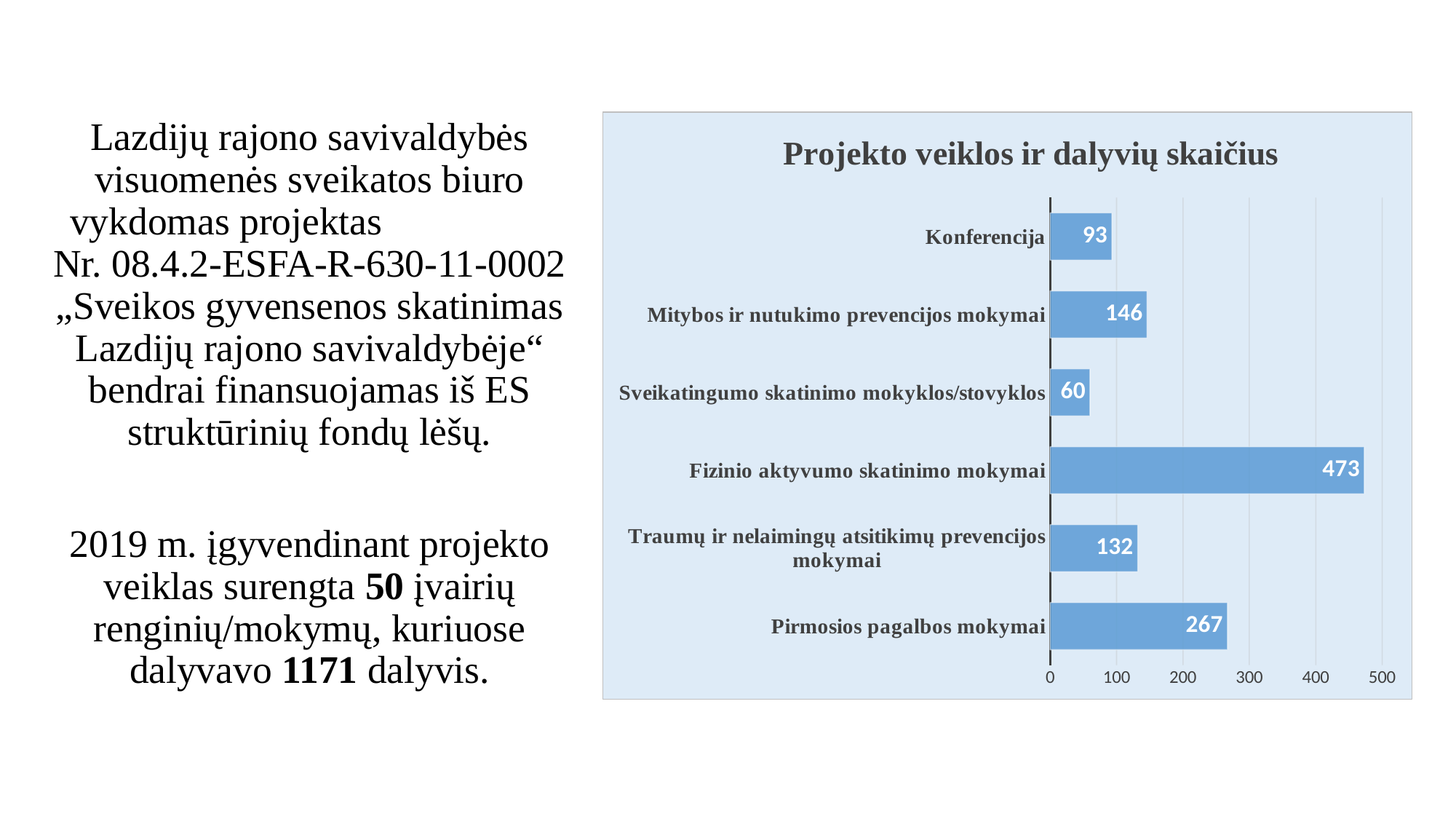
What is the value for Konferencija? 93 Which is larger, the value for Mitybos ir nutukimo prevencijos mokymai or the value for Traumų ir nelaimingų atsitikimų prevencijos mokymai? Mitybos ir nutukimo prevencijos mokymai What is the difference between the values for Fizinio aktyvumo skatinimo mokymai and Pirmosios pagalbos mokymai? 206 What is the title of the chart? Projekto veiklos ir dalyvių skaičius What kind of chart is shown on the slide? bar chart Which category has the highest value? Fizinio aktyvumo skatinimo mokymai What is the value for Fizinio aktyvumo skatinimo mokymai? 473 How many categories are shown in the chart? 6 Which category has the lowest value? Sveikatingumo skatinimo mokyklos/stovyklos What is the value for Sveikatingumo skatinimo mokyklos/stovyklos? 60 What is the value for Pirmosios pagalbos mokymai? 267 Is the value for Pirmosios pagalbos mokymai greater or less than 200? greater